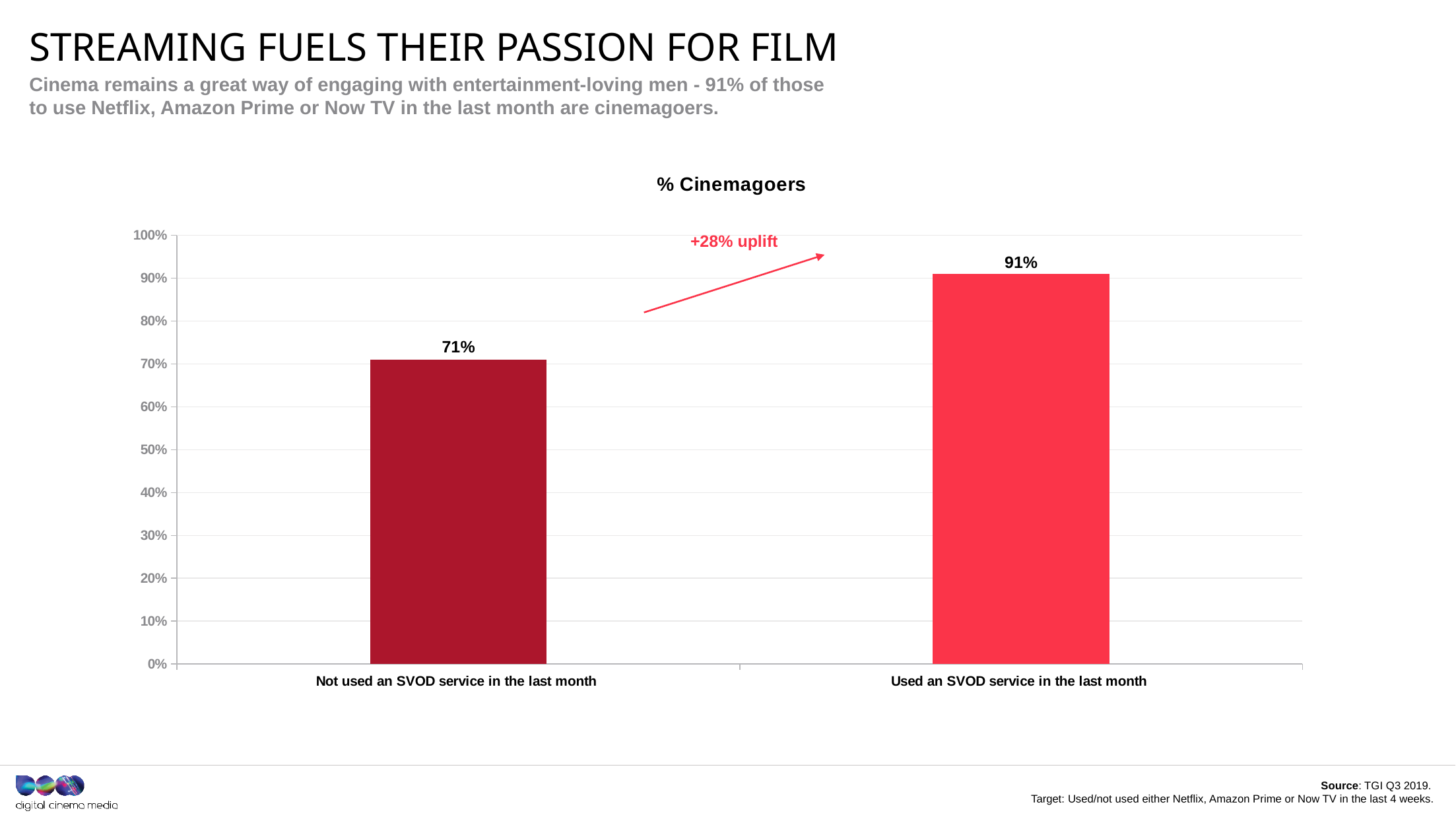
What is the difference in percentage points between the two bars? 20 Which category has the lower percentage of cinemagoers? Not used an SVOD service in the last month Is the value for 'Used an SVOD service in the last month' larger or smaller than the value for 'Not used an SVOD service in the last month'? larger What percentage of those who have used an SVOD service in the last month are cinemagoers? 91% Is the value for 'Used an SVOD service in the last month' greater or less than 90%? greater What is the title of the chart? % Cinemagoers How many categories are shown on the chart? 2 What type of chart is shown on the slide? Bar chart What uplift is annotated on the chart between the two bars? +28% uplift What percentage of those who have not used an SVOD service in the last month are cinemagoers? 71% Which category has the higher percentage of cinemagoers? Used an SVOD service in the last month Is the value for 'Not used an SVOD service in the last month' greater or less than 80%? less